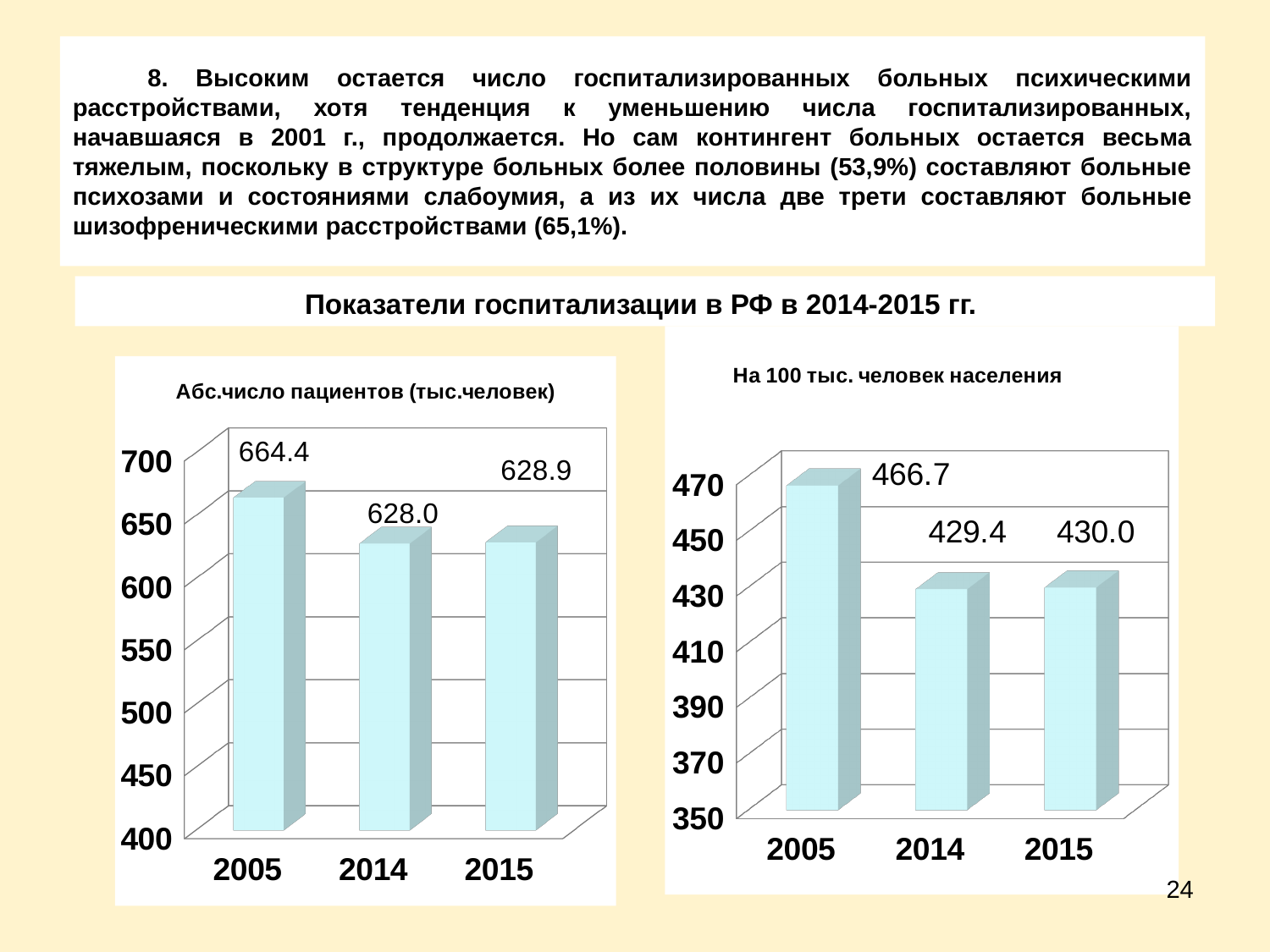
What is the overall title shown above the two charts on the slide? Показатели госпитализации в РФ в 2014-2015 гг. In the chart titled "На 100 тыс. человек населения", which is larger, the value for 2005 or the value for 2015? 2005 In the chart titled "Абс.число пациентов (тыс.человек)", what is the value for 2005? 664.4 In the chart titled "На 100 тыс. человек населения", which year has the lowest value? 2014 In the chart titled "На 100 тыс. человек населения", what is the value for 2015? 430.0 In the chart titled "На 100 тыс. человек населения", what is the value for 2014? 429.4 How many years are shown on the x axis of the chart titled "Абс.число пациентов (тыс.человек)"? 3 In the chart titled "На 100 тыс. человек населения", what is the difference between the values for 2005 and 2014? 37.3 What kind of chart is the chart titled "На 100 тыс. человек населения"? Bar chart In the chart titled "Абс.число пациентов (тыс.человек)", which year has the highest value? 2005 In the chart titled "Абс.число пациентов (тыс.человек)", what is the value for 2014? 628.0 In the chart titled "Абс.число пациентов (тыс.человек)", what is the difference between the values for 2005 and 2015? 35.5